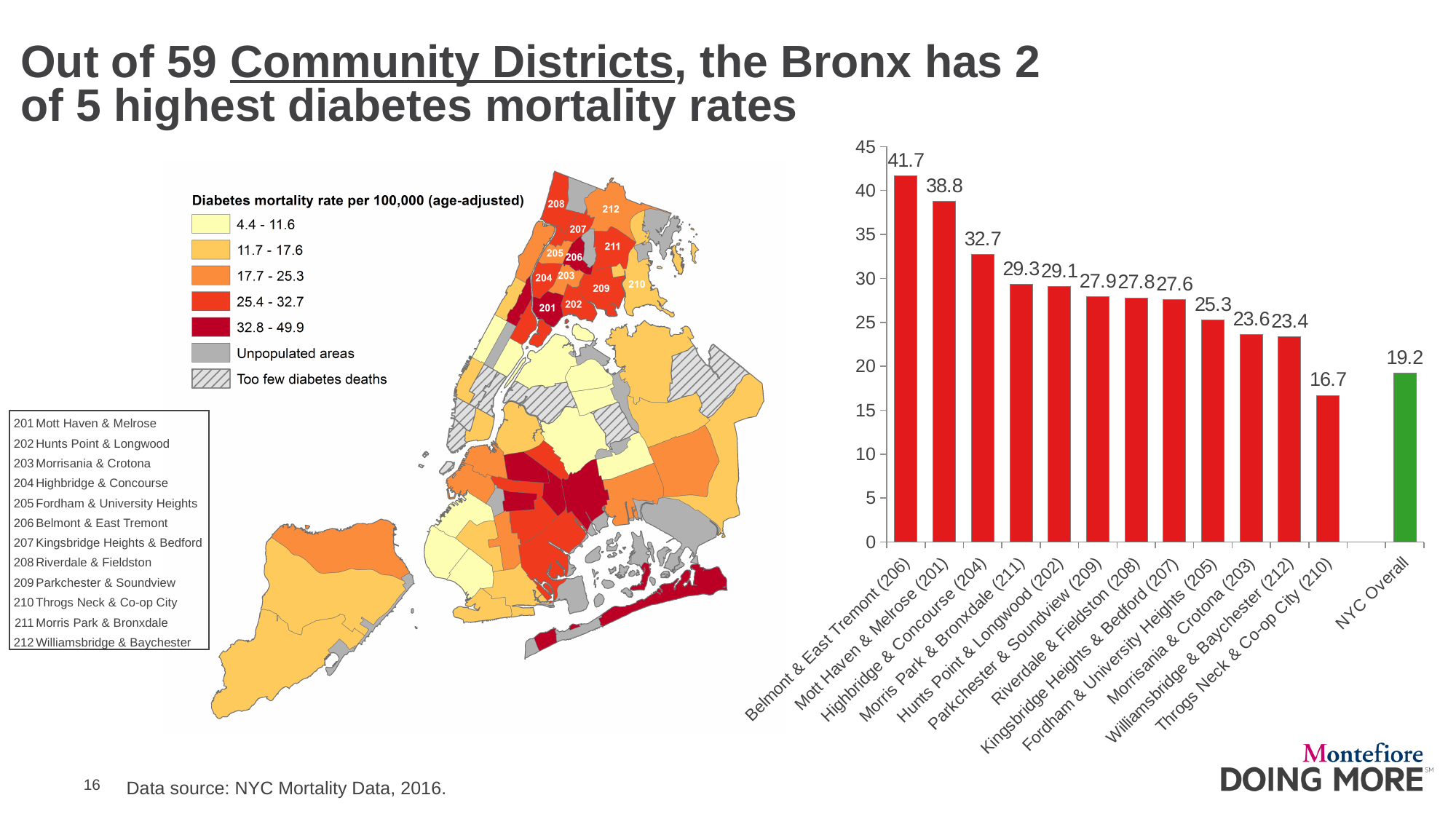
In the bar chart, is the value for Riverdale & Fieldston (208) greater or less than 25? greater In the bar chart, what is the difference between the values for Mott Haven & Melrose (201) and Highbridge & Concourse (204)? 6.1 In the bar chart, which community district has the highest diabetes mortality rate? Belmont & East Tremont (206) What kind of chart is shown on the right side of the slide? Bar chart In the bar chart, what is the diabetes mortality rate for Belmont & East Tremont (206)? 41.7 How many bars are shown in the bar chart? 13 In the bar chart, what is the value for Throgs Neck & Co-op City (210)? 16.7 In the bar chart, what is the difference between the value for Belmont & East Tremont (206) and NYC Overall? 22.5 In the bar chart, what colour is the NYC Overall bar? Green In the bar chart, which is larger: the value for Fordham & University Heights (205) or the value for Morrisania & Crotona (203)? Fordham & University Heights (205) In the bar chart, what is the value for NYC Overall? 19.2 In the bar chart, which community district has the lowest diabetes mortality rate? Throgs Neck & Co-op City (210)